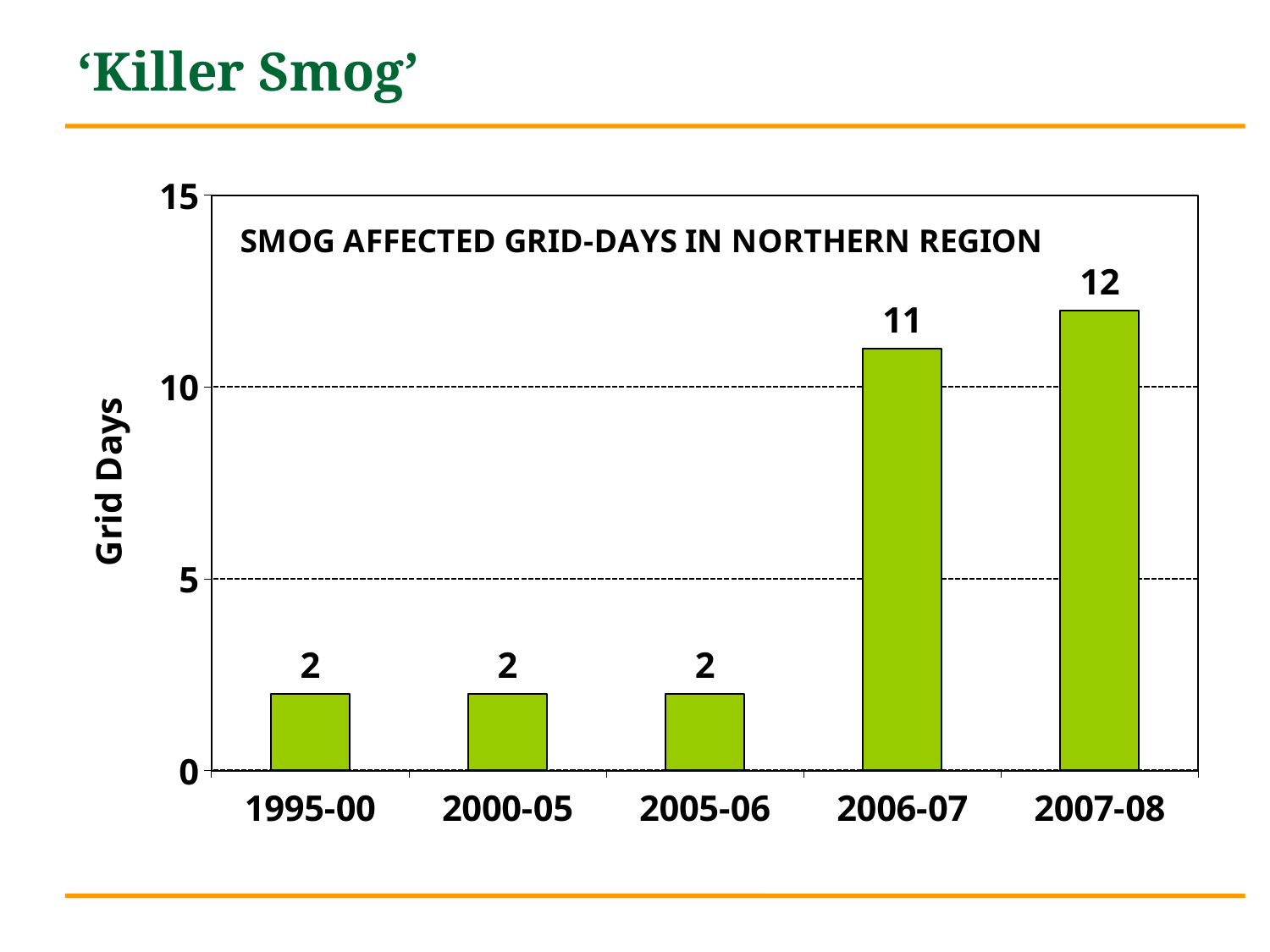
What is the value for 1995-00? 2 How many periods are shown on the x axis? 5 What is the label on the y axis? Grid Days What is the value for 2006-07? 11 What is the difference between the values for 2006-07 and 2005-06? 9 What is the value for 2007-08? 12 Which period has the highest number of smog affected grid-days? 2007-08 Is the value for 2000-05 greater or less than 5? less What is the difference between the values for 2007-08 and 2006-07? 1 Is the value for 2007-08 greater or less than 10? greater What kind of chart is shown on the slide? bar chart Which is larger, the value for 2006-07 or the value for 2000-05? 2006-07